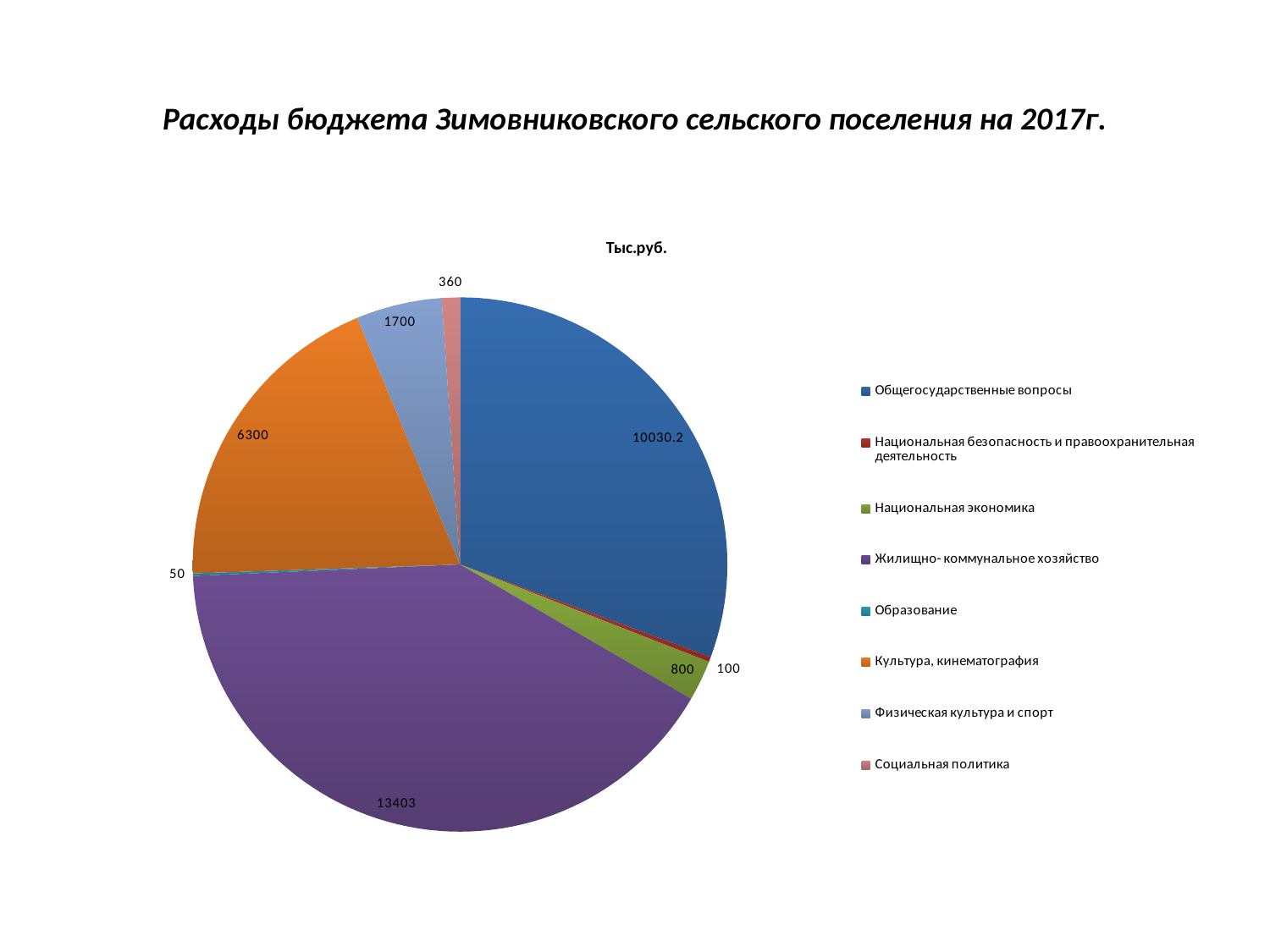
What is the value for Жилищно-коммунальное хозяйство? 13403 What is the value for Общегосударственные вопросы? 10030.2 Which category has the largest slice of the pie? Жилищно-коммунальное хозяйство How many categories does the legend list? 8 What is the value for Физическая культура и спорт? 1700 What is the value for Культура, кинематография? 6300 What is the value for Образование? 50 What kind of chart is shown on the slide? pie chart Which is larger, the value for Культура, кинематография or the value for Физическая культура и спорт? Культура, кинематография What unit is given in the chart title above the pie? Тыс.руб. What is the difference between the values for Жилищно-коммунальное хозяйство and Общегосударственные вопросы? 3372.8 Which category has the smallest slice of the pie? Образование